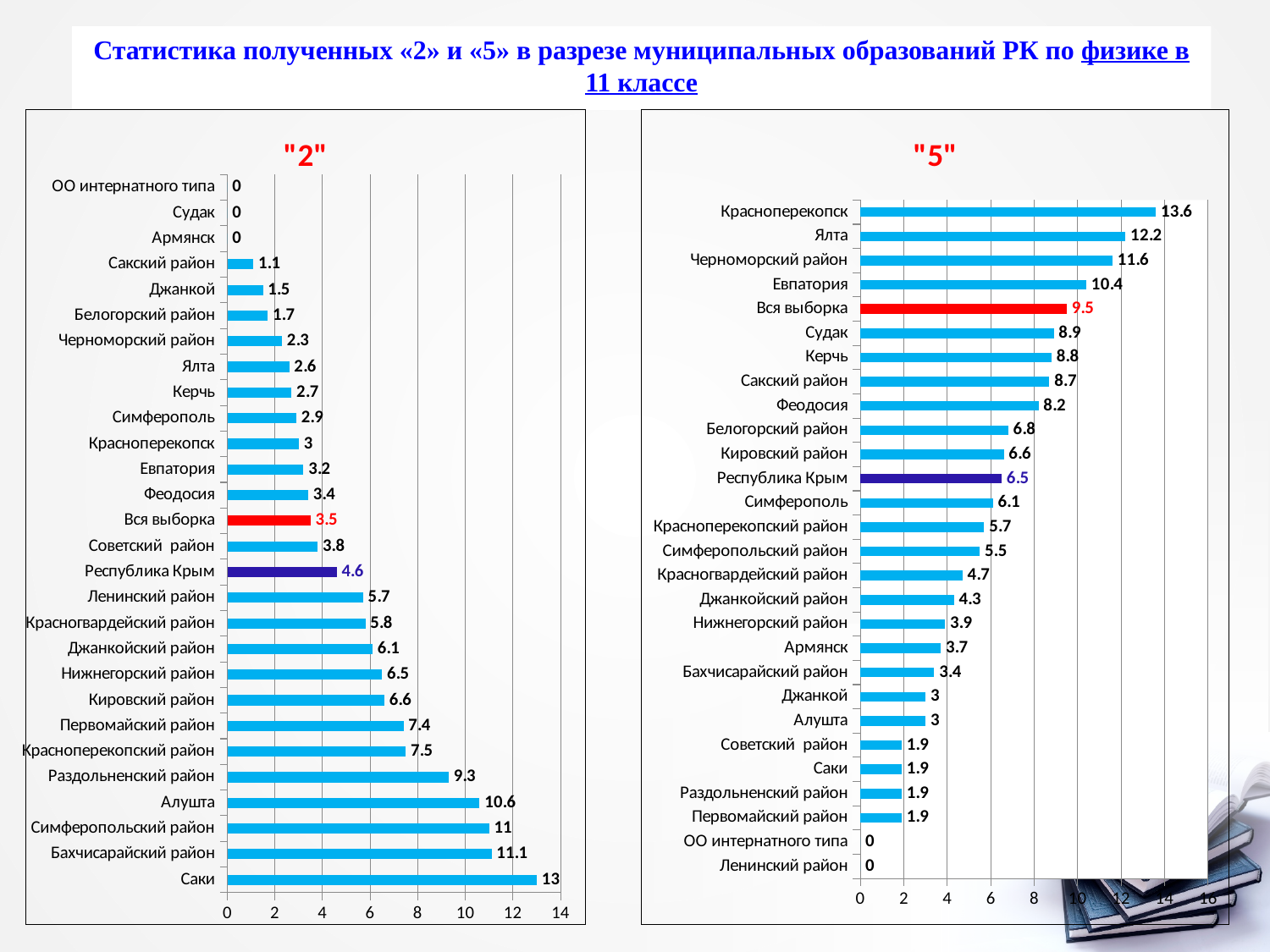
In the "5" chart, what colour is the bar for Вся выборка? red In the "2" chart, what is the value for Республика Крым? 4.6 In the "5" chart, what is the value for Вся выборка? 9.5 In the "2" chart, what is the value for Саки? 13 In the "2" chart, is the value for Раздольненский район greater or less than 8? greater In the "2" chart, which category has the highest value? Саки In the "5" chart, which is larger, the value for Евпатория or the value for Судак? Евпатория What kind of chart is the "2" chart? bar chart In the "5" chart, which category has the highest value? Красноперекопск How many categories are shown in the "5" chart? 28 In the "2" chart, what is the difference between Бахчисарайский район and Алушта? 0.5 In the "5" chart, what is the difference between Красноперекопск and Ялта? 1.4